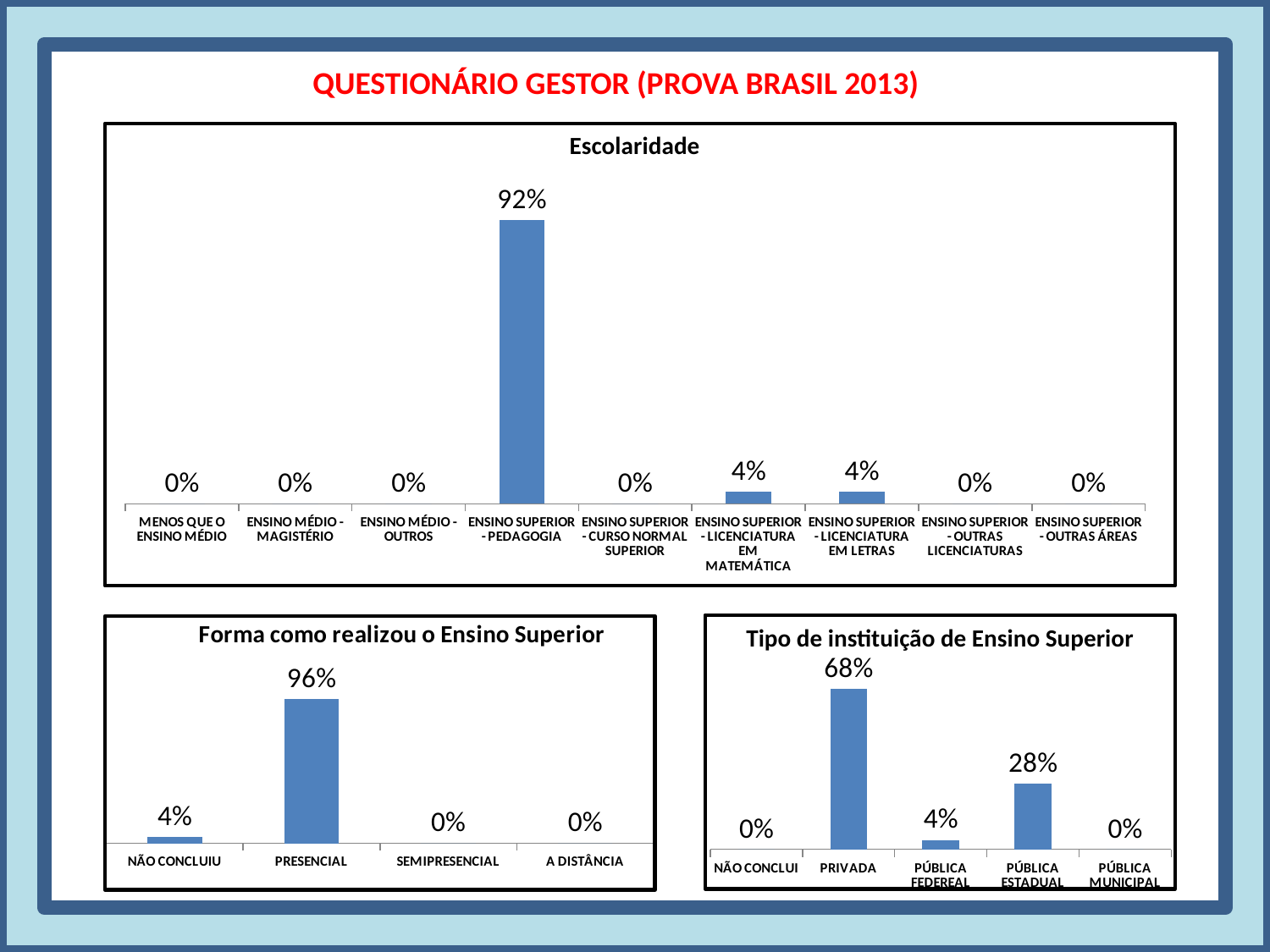
What kind of chart is the "Tipo de instituição de Ensino Superior" chart? Bar chart In the "Escolaridade" chart, what is the value for ENSINO SUPERIOR - LICENCIATURA EM MATEMÁTICA? 4% In the "Tipo de instituição de Ensino Superior" chart, what is the value for PRIVADA? 68% In the "Tipo de instituição de Ensino Superior" chart, which is larger, PRIVADA or PÚBLICA ESTADUAL? PRIVADA In the "Escolaridade" chart, what is the value for ENSINO SUPERIOR - PEDAGOGIA? 92% In the "Escolaridade" chart, which category has the highest value? ENSINO SUPERIOR - PEDAGOGIA In the "Escolaridade" chart, how many categories are shown on the x axis? 9 In the "Forma como realizou o Ensino Superior" chart, how many categories are shown? 4 In the "Forma como realizou o Ensino Superior" chart, what is the value for NÃO CONCLUIU? 4% In the "Escolaridade" chart, what is the difference between ENSINO SUPERIOR - PEDAGOGIA and ENSINO SUPERIOR - LICENCIATURA EM LETRAS? 88% In the "Forma como realizou o Ensino Superior" chart, what is the value for PRESENCIAL? 96% In the "Tipo de instituição de Ensino Superior" chart, what is the value for PÚBLICA ESTADUAL? 28%